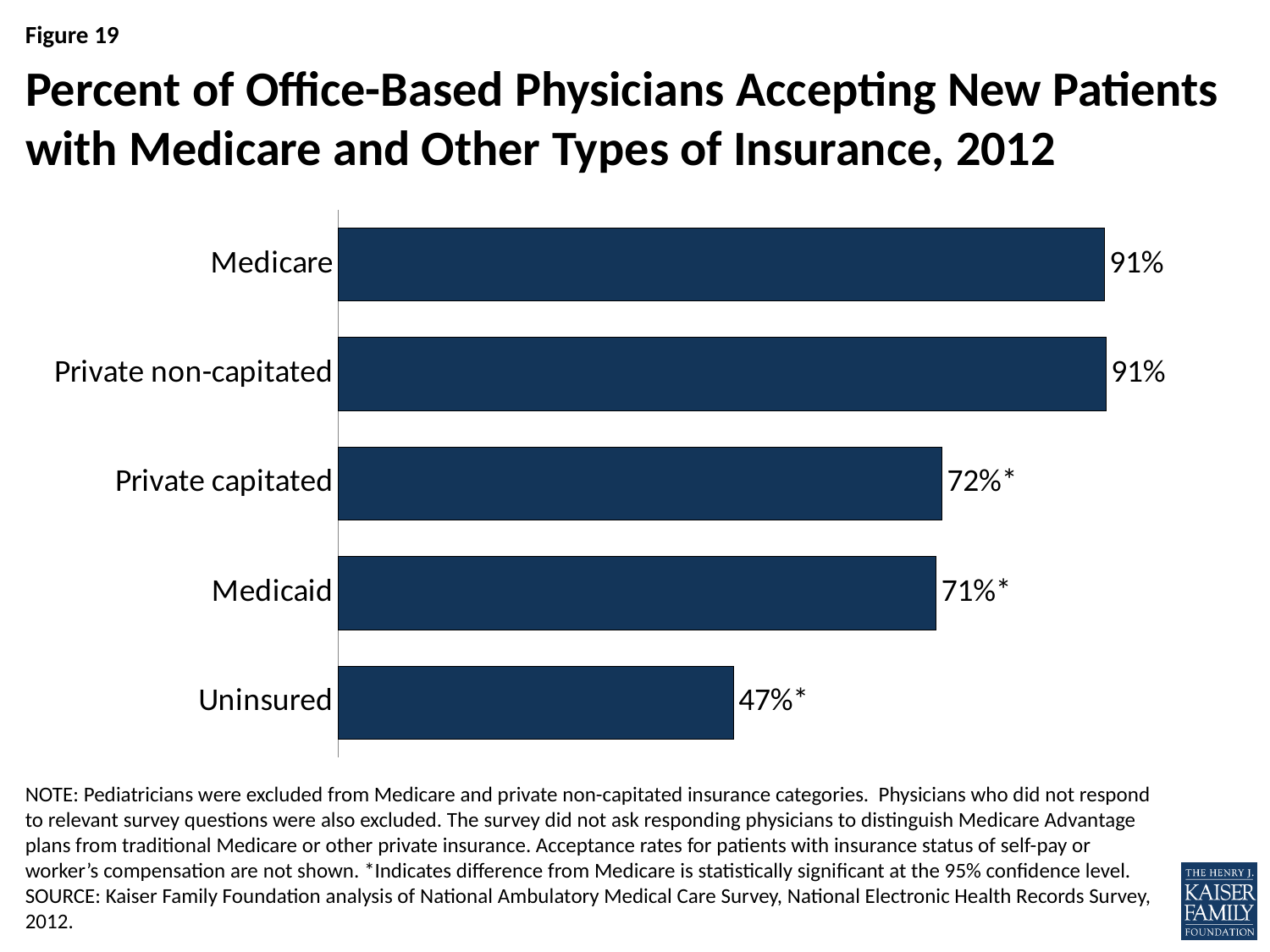
What is the value shown for Uninsured? 47% What is the value shown for Private capitated? 72% What percent of office-based physicians accept new patients with Medicare? 91% What is the difference in percentage points between Medicare and Uninsured? 44 What is the value shown for Medicaid? 71% Which is larger, the value for Medicaid or the value for Uninsured? Medicaid How many insurance categories are shown in the chart? 5 Which two categories share the same value of 91%? Medicare and Private non-capitated What is the difference in percentage points between Private capitated and Medicaid? 1 What kind of chart is shown on the slide? Bar chart Which category has the lowest acceptance rate? Uninsured What is the value shown for Private non-capitated? 91%